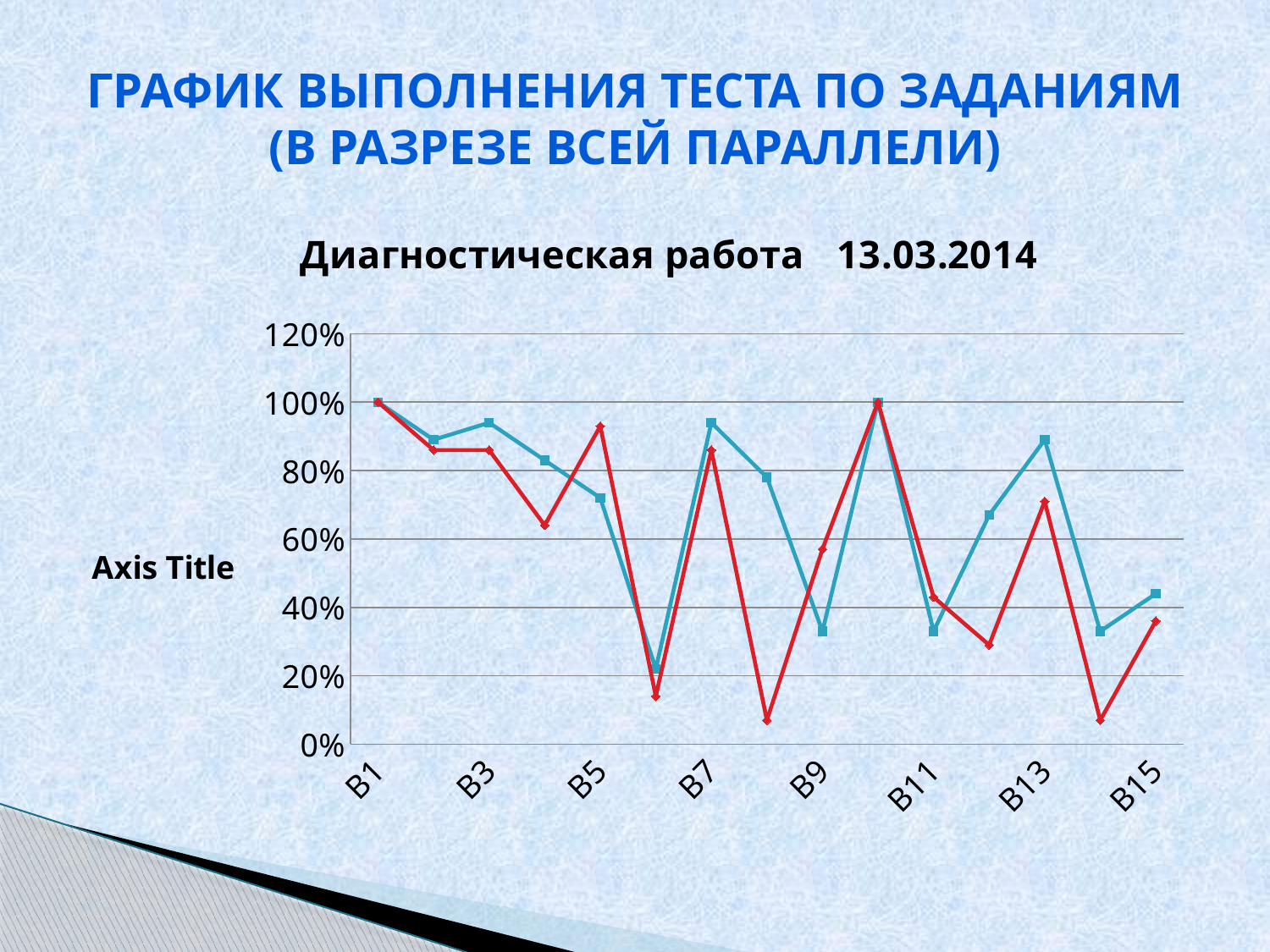
What is the value of the blue line at B1? 100% What is the title of the chart? Диагностическая работа 13.03.2014 Is the value of the red line at B8 greater or less than 20%? less Is the value of the blue line at B13 greater or less than 80%? greater What is the value of the red line at B10? 100% At B8, which line has the higher value, the blue line or the red line? blue line Does the red line rise or fall from B1 to B2? fall At B5, which line has the higher value, the blue line or the red line? red line How many categories (B1 to B15) are plotted along the x axis? 15 Is the value of the red line at B14 greater or less than 20%? less What kind of chart is shown on the slide? line chart